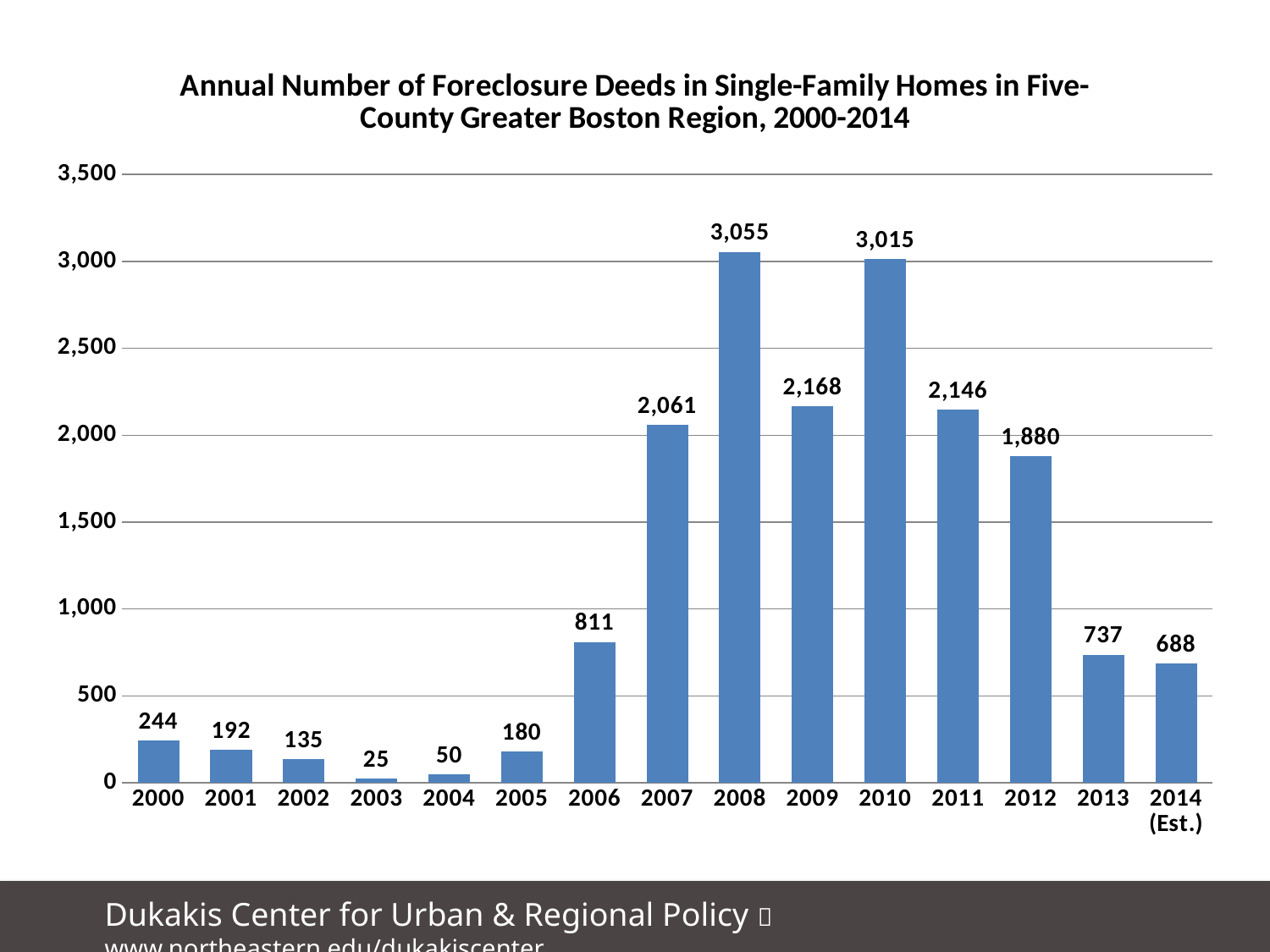
Which year has the lowest number of foreclosure deeds? 2003 What is the number of foreclosure deeds in 2003? 25 What is the difference between the number of foreclosure deeds in 2008 and in 2010? 40 What is the difference between the number of foreclosure deeds in 2007 and in 2006? 1,250 Do the values rise or fall from 2010 to 2014? Fall What kind of chart is shown on the slide? Bar chart What is the estimated number of foreclosure deeds in 2014? 688 What is the number of foreclosure deeds in 2008? 3,055 How many years are shown on the x axis? 15 Which year had more foreclosure deeds, 2009 or 2011? 2009 Is the value for 2012 greater or less than 1,500? greater Which year has the highest number of foreclosure deeds? 2008